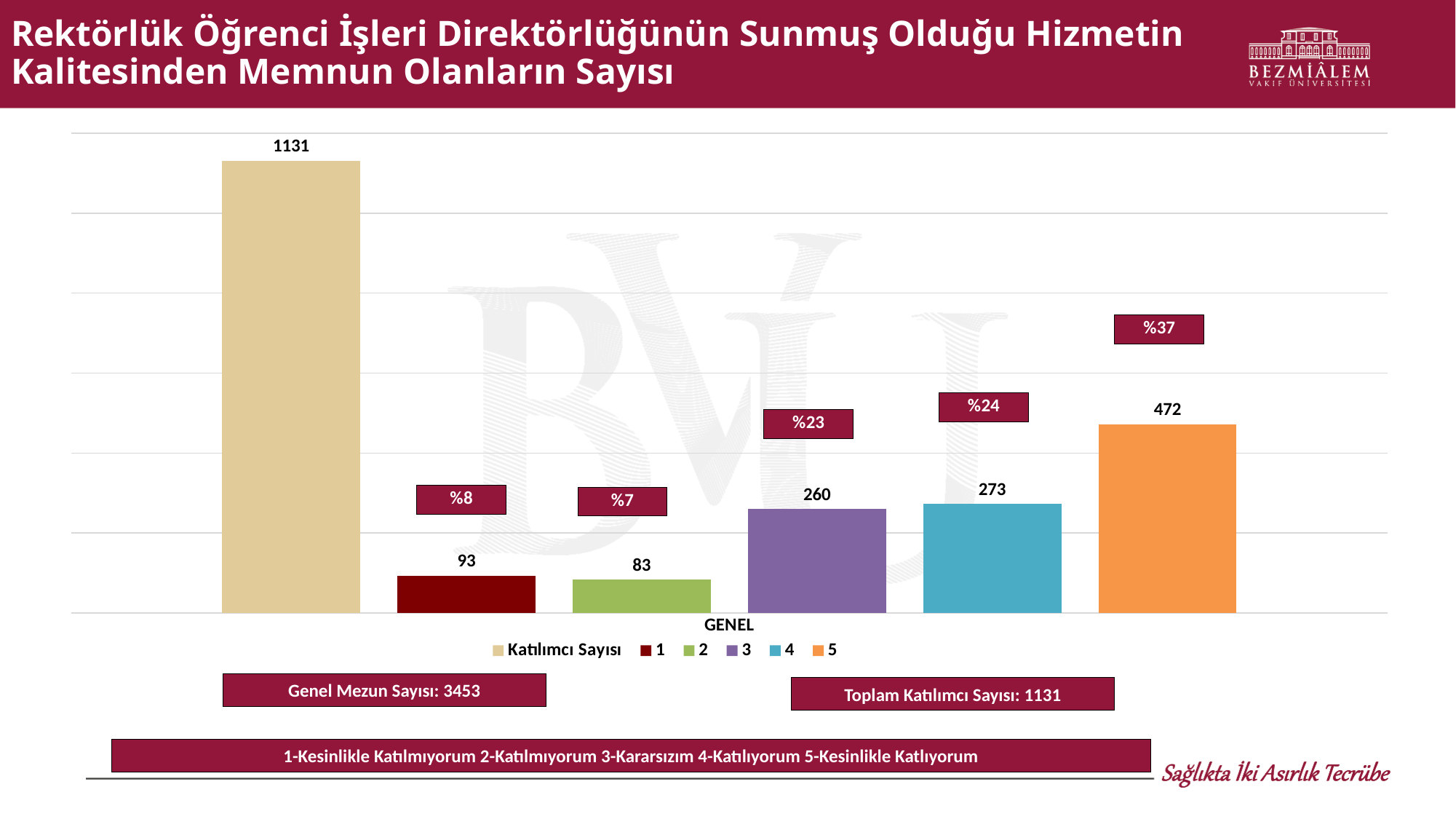
What percentage label is shown above the bar for series 5? %37 Which is larger, the value for series 4 or the value for series 3? 4 What is the value of the 'Katılımcı Sayısı' bar? 1131 What is the value of the bar for series 2? 83 What is the value of the bar for series 5? 472 What is the difference between the values for series 5 and series 4? 199 How many series does the legend list? 6 What is the difference between the values for series 1 and series 2? 10 Among the response series 1 to 5, which has the lowest value? 2 What kind of chart is shown on the slide? Bar chart Among the response series 1 to 5, which has the highest value? 5 What is the value of the bar for series 3? 260